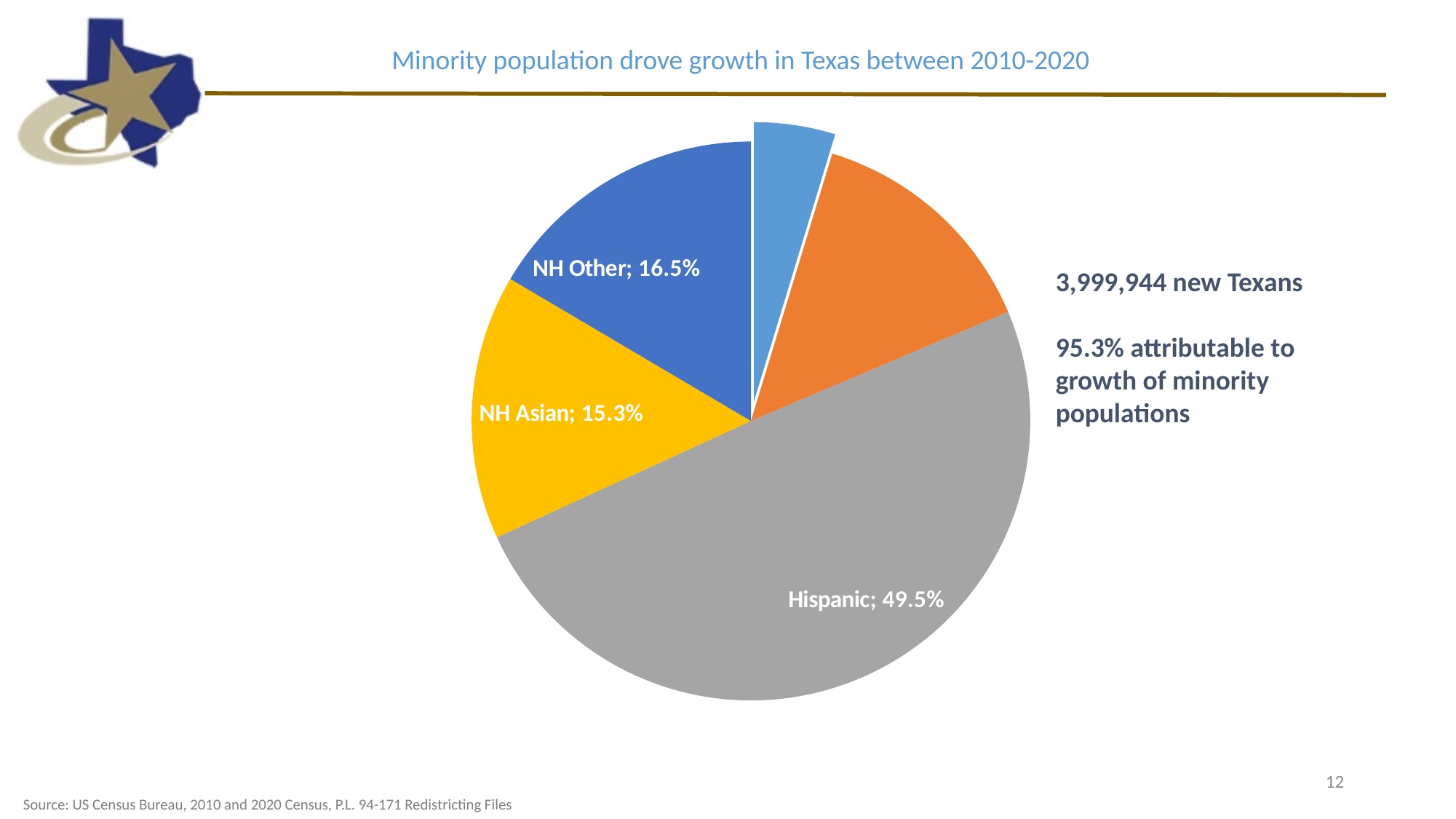
What is the title of the slide containing the pie chart? Minority population drove growth in Texas between 2010-2020 How many slices does the pie chart have? 5 How many slices of the pie chart have a printed label with a value? 3 What is the value shown for NH Asian? 15.3% What is the value shown for NH Other? 16.5% What is the difference in percentage points between NH Other and NH Asian? 1.2 percentage points What kind of chart is shown on the slide? pie chart What is the difference in percentage points between Hispanic and NH Other? 33.0 percentage points What share of the pie does the Hispanic slice represent? 49.5% Which labeled category has the largest slice of the pie? Hispanic What colour is the Hispanic slice of the pie chart? grey Which is larger, the NH Other slice or the NH Asian slice? NH Other